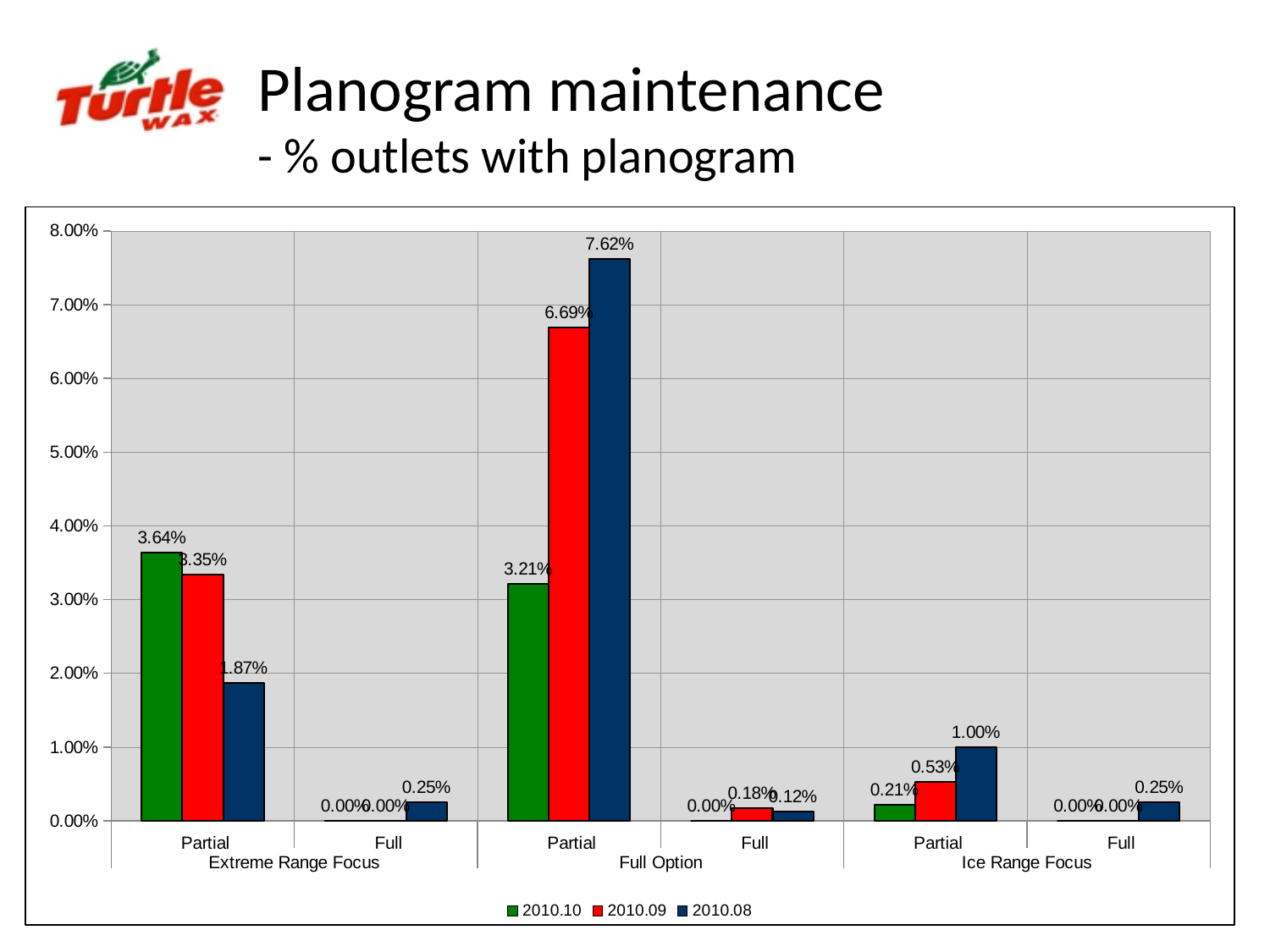
What kind of chart is shown on the slide? Bar chart What is the value for 2010.08 in the Full Option Partial category? 7.62% What is the value for 2010.08 in the Ice Range Focus Partial category? 1.00% What is the value for 2010.10 in the Extreme Range Focus Partial category? 3.64% What is the difference between the 2010.08 and 2010.09 values in the Full Option Partial category? 0.93% Which colour represents the 2010.09 series in the legend? Red Which series has the highest value in the Full Option Partial category? 2010.08 What is the value for 2010.09 in the Ice Range Focus Partial category? 0.53% How many series does the legend list? 3 Which series has the lowest value in the Extreme Range Focus Partial category? 2010.08 Which is larger: the 2010.10 value for Extreme Range Focus Partial or the 2010.10 value for Full Option Partial? Extreme Range Focus Partial What is the difference between the 2010.10 and 2010.09 values in the Extreme Range Focus Partial category? 0.29%